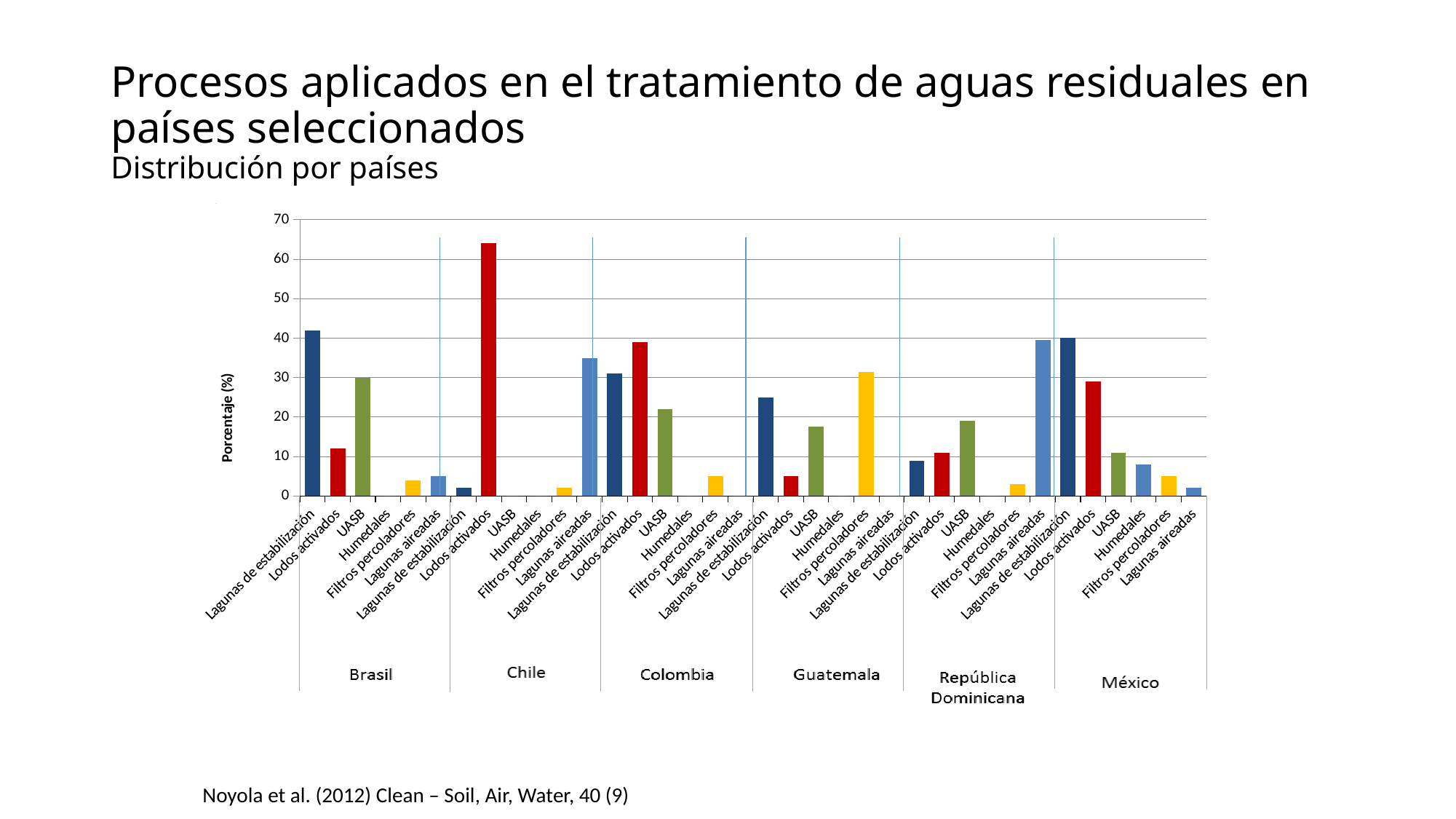
Which is larger in República Dominicana: Lagunas aireadas or UASB? Lagunas aireadas Which country and process has the tallest bar in the chart? Chile, Lodos activados Is the value for Lodos activados in Guatemala greater or less than 10? less How many treatment processes are listed for each country? 6 Is the value for UASB in Colombia greater or less than 20? greater Is the value for Lodos activados in Chile greater or less than 60? greater What kind of chart is shown on the slide? bar chart How many countries are shown along the x axis? 6 Which is larger in Colombia: Lodos activados or Lagunas de estabilización? Lodos activados Which process has the highest value in México? Lagunas de estabilización What is the label of the vertical axis? Porcentaje (%)